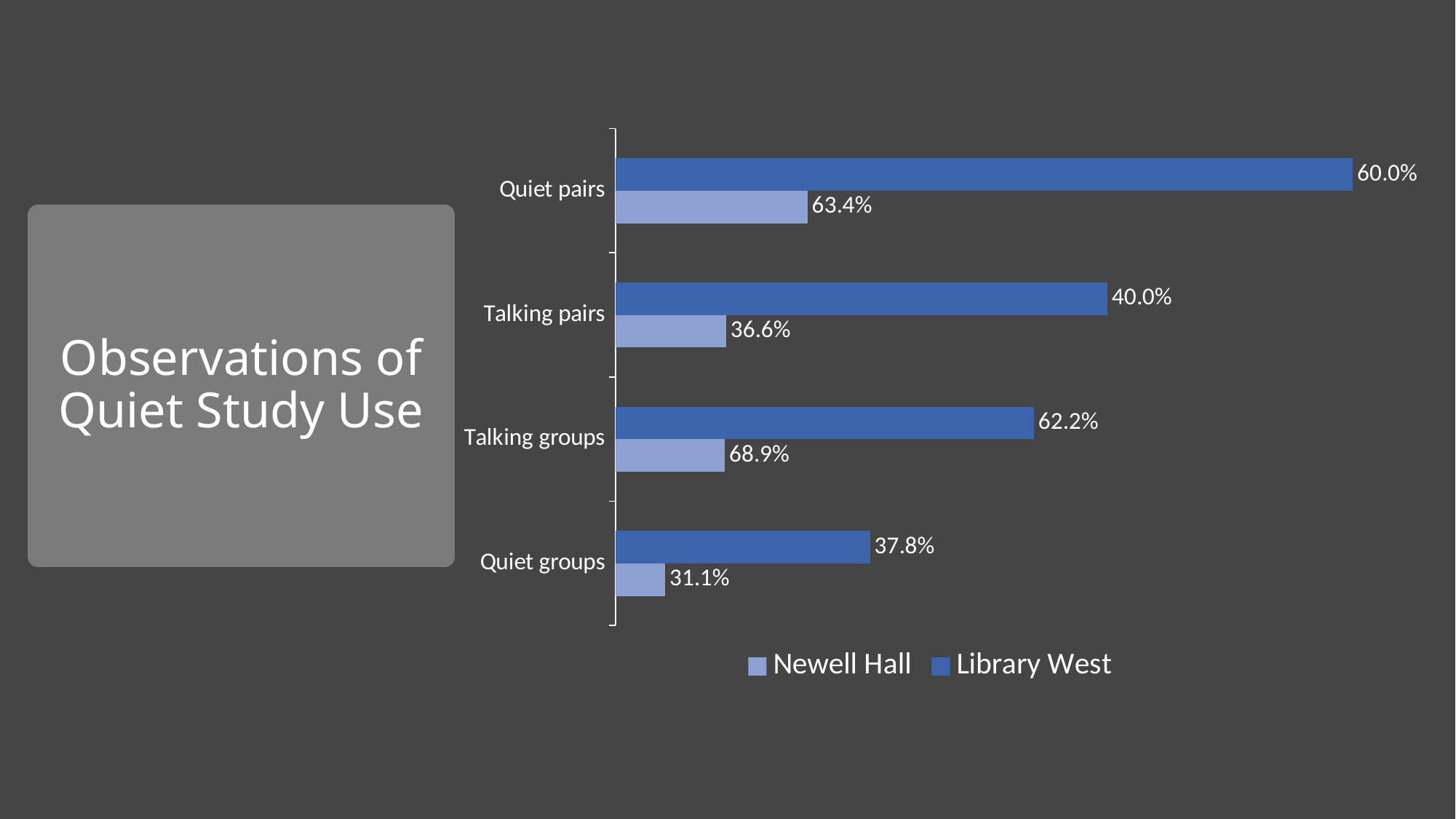
What is the difference between the Library West and Newell Hall values for Talking pairs? 3.4 percentage points Which category has the lowest Library West value? Quiet groups What is the Library West value for Talking pairs? 40.0% What is the Newell Hall value for Quiet groups? 31.1% What is the Library West value for Quiet pairs? 60.0% What kind of chart is shown on the slide? Bar chart What is the difference between the Newell Hall and Library West values for Talking groups? 6.7 percentage points What is the Newell Hall value for Talking groups? 68.9% For Library West, which is larger: Talking groups or Quiet groups? Talking groups How many categories are shown on the chart? 4 How many series does the legend list? 2